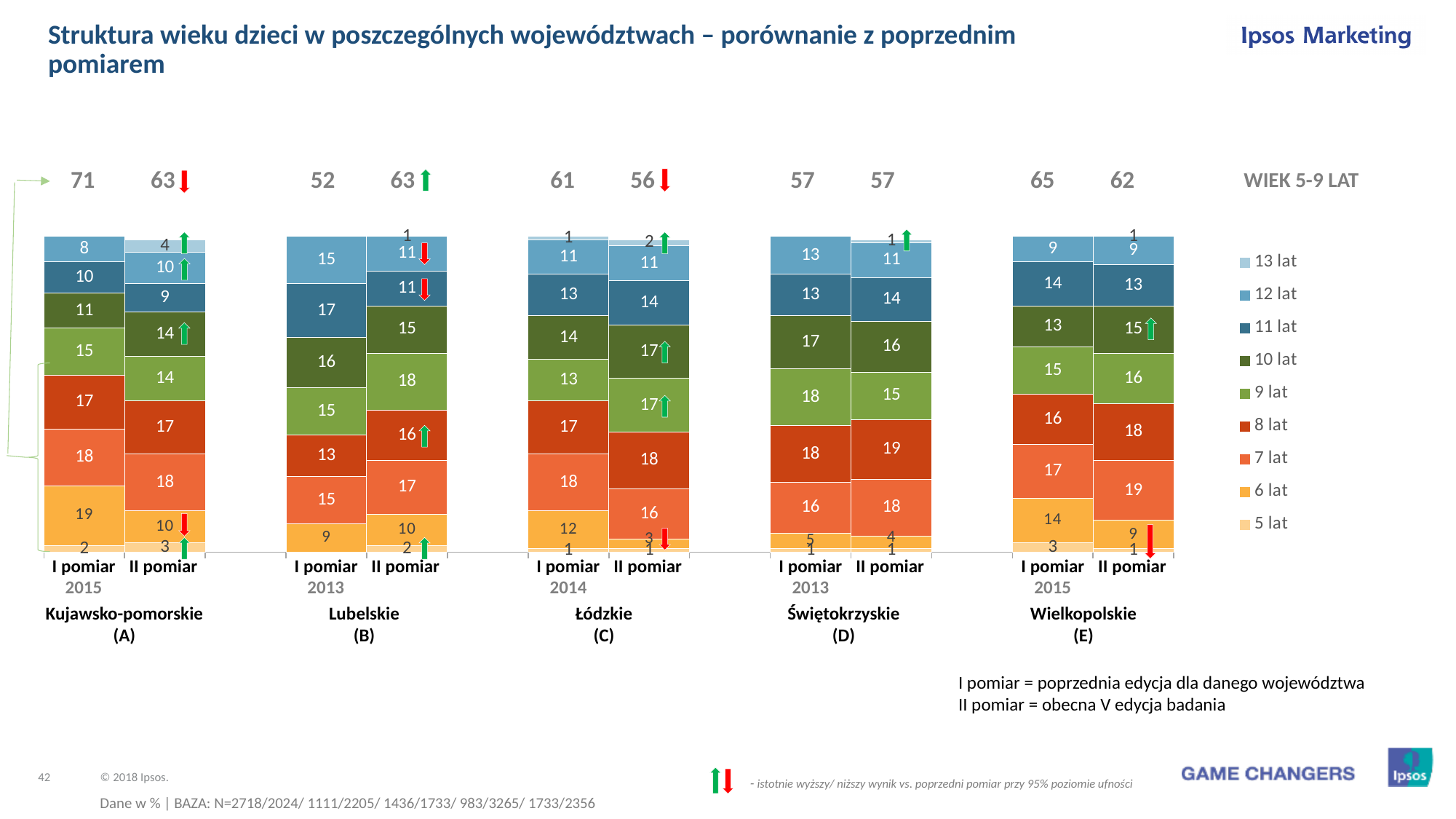
Which year is shown under the I pomiar bar for Łódzkie (C)? 2014 How many series does the legend list? 9 What is the difference between the WIEK 5-9 LAT values for I pomiar and II pomiar in Lubelskie (B)? 11 What kind of chart is shown on the slide? stacked bar chart What is the value for 6 lat in the I pomiar bar for Kujawsko-pomorskie (A)? 19 What is the difference between the 6 lat values for I pomiar and II pomiar in Kujawsko-pomorskie (A)? 9 What is the WIEK 5-9 LAT value shown above the II pomiar bar for Łódzkie (C)? 56 Which is larger: the 7 lat value in the II pomiar bar for Wielkopolskie (E) or the 7 lat value in the II pomiar bar for Łódzkie (C)? Wielkopolskie (E) II pomiar Which bar has the highest WIEK 5-9 LAT value shown above it? Kujawsko-pomorskie (A) I pomiar What is the value for 8 lat in the II pomiar bar for Świętokrzyskie (D)? 19 How many bars are plotted in the chart? 10 What is the value for 9 lat in the II pomiar bar for Lubelskie (B)? 18